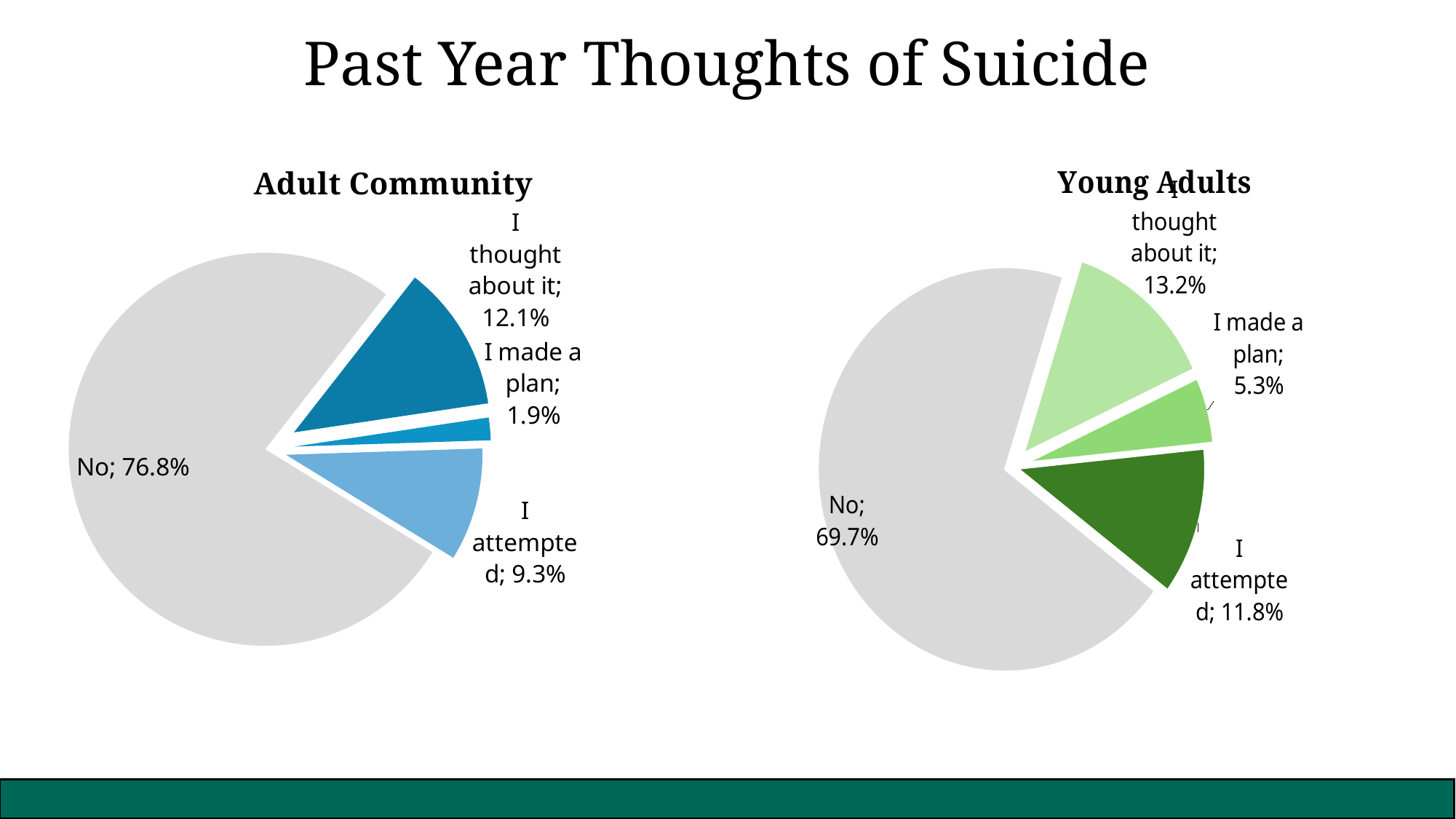
What is the difference between the "No" share in the Adult Community chart and the "No" share in the Young Adults chart? 7.1% Which is larger: "I attempted" in the Adult Community chart or "I attempted" in the Young Adults chart? Young Adults What type of chart is used for the Adult Community data? Pie chart In the Young Adults chart, what is the difference between "I thought about it" and "I made a plan"? 7.9% In the Adult Community chart, what is the value for "I made a plan"? 1.9% In the Young Adults chart, what share of respondents said "I attempted"? 11.8% In the Young Adults chart, which category has the largest slice? No What is the title of the slide? Past Year Thoughts of Suicide In the Adult Community chart, which category has the smallest slice? I made a plan In the Adult Community chart, what share of respondents answered "No"? 76.8% How many slices does the Young Adults pie chart have? 4 In the Young Adults chart, what is the value for "I thought about it"? 13.2%